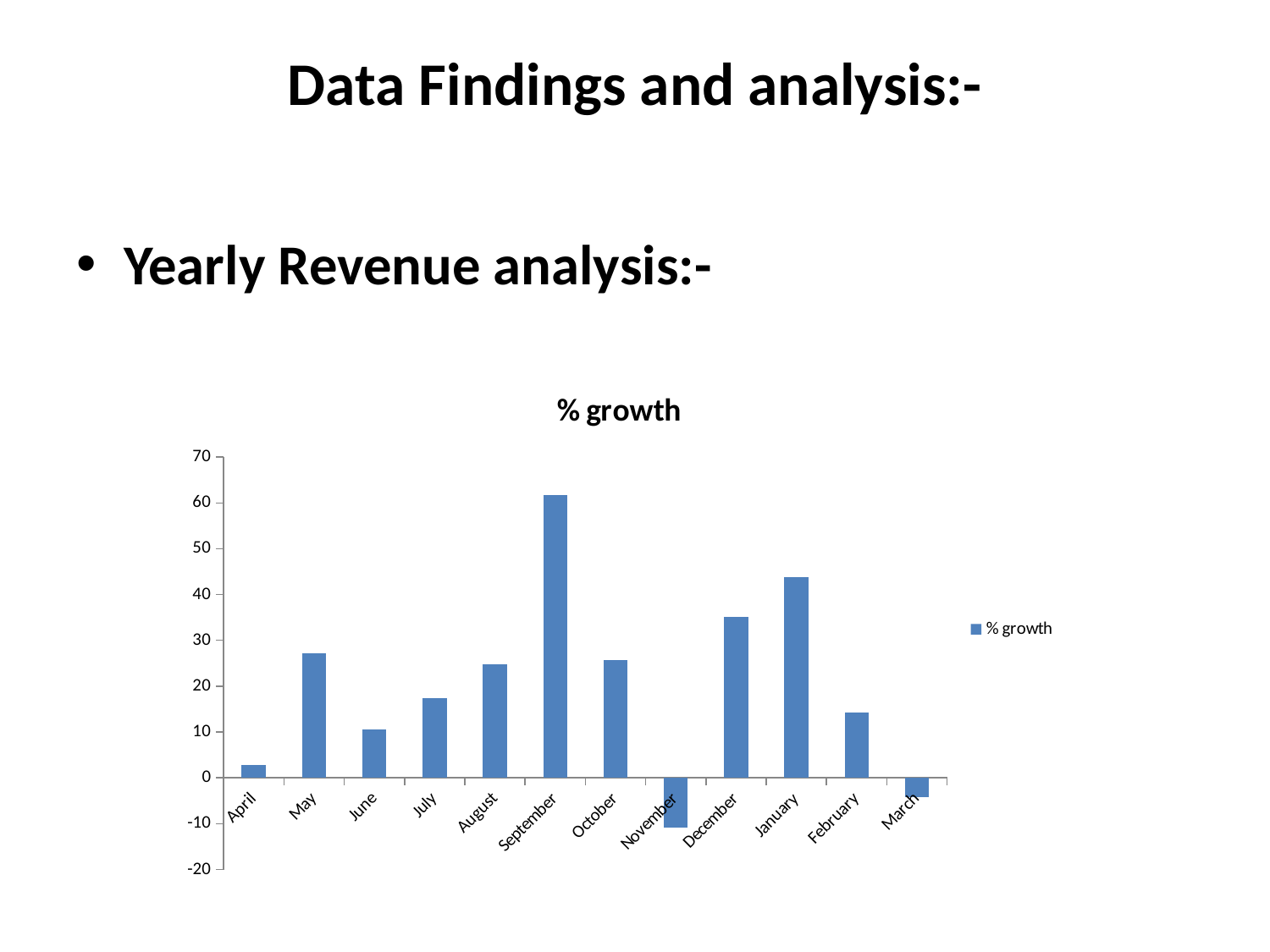
Which month has a higher % growth, January or February? January Which month has a higher % growth, May or June? May Is the % growth value for November greater or less than 0? less Which month has the lowest % growth? November How many series does the legend of the % growth chart list? 1 Is the % growth value for January greater or less than 40? greater How many months are plotted on the x axis of the % growth chart? 12 Is the % growth value for September greater or less than 50? greater Which month has the highest % growth? September What is the title of the chart on the slide? % growth What kind of chart is shown on the slide? bar chart